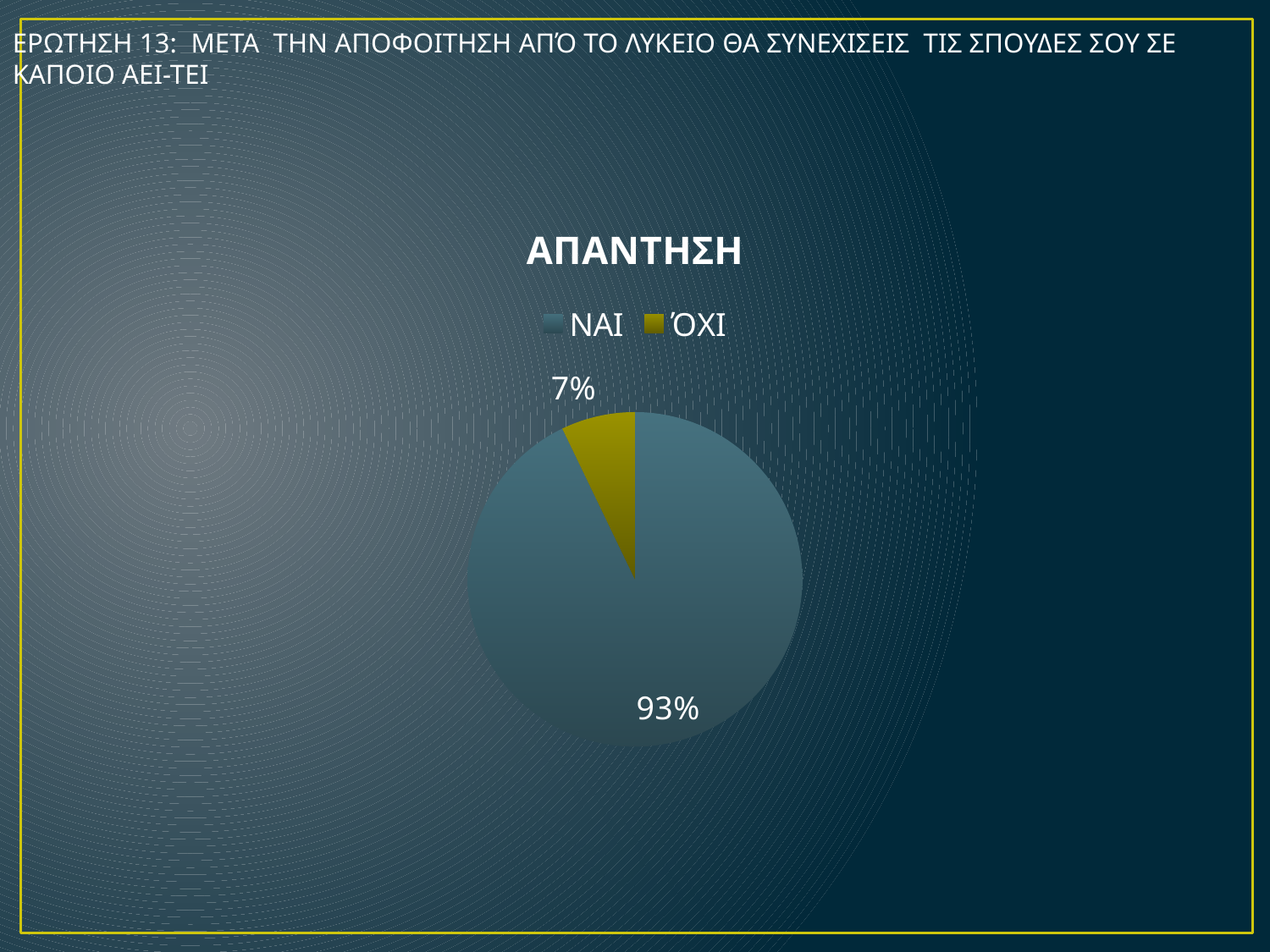
What percentage of the pie is labelled ΝΑΙ? 93% How many slices does the pie chart have? 2 What percentage of the pie is labelled ΌΧΙ? 7% What colour is the ΌΧΙ slice? yellow Which is larger, the ΝΑΙ slice or the ΌΧΙ slice? ΝΑΙ How many entries does the legend list? 2 What is the difference in percentage points between the ΝΑΙ and ΌΧΙ slices? 86 What kind of chart is shown on the slide? pie chart Which category has the largest share of the pie? ΝΑΙ Which category has the smallest share of the pie? ΌΧΙ What is the chart's title? ΑΠΑΝΤΗΣΗ